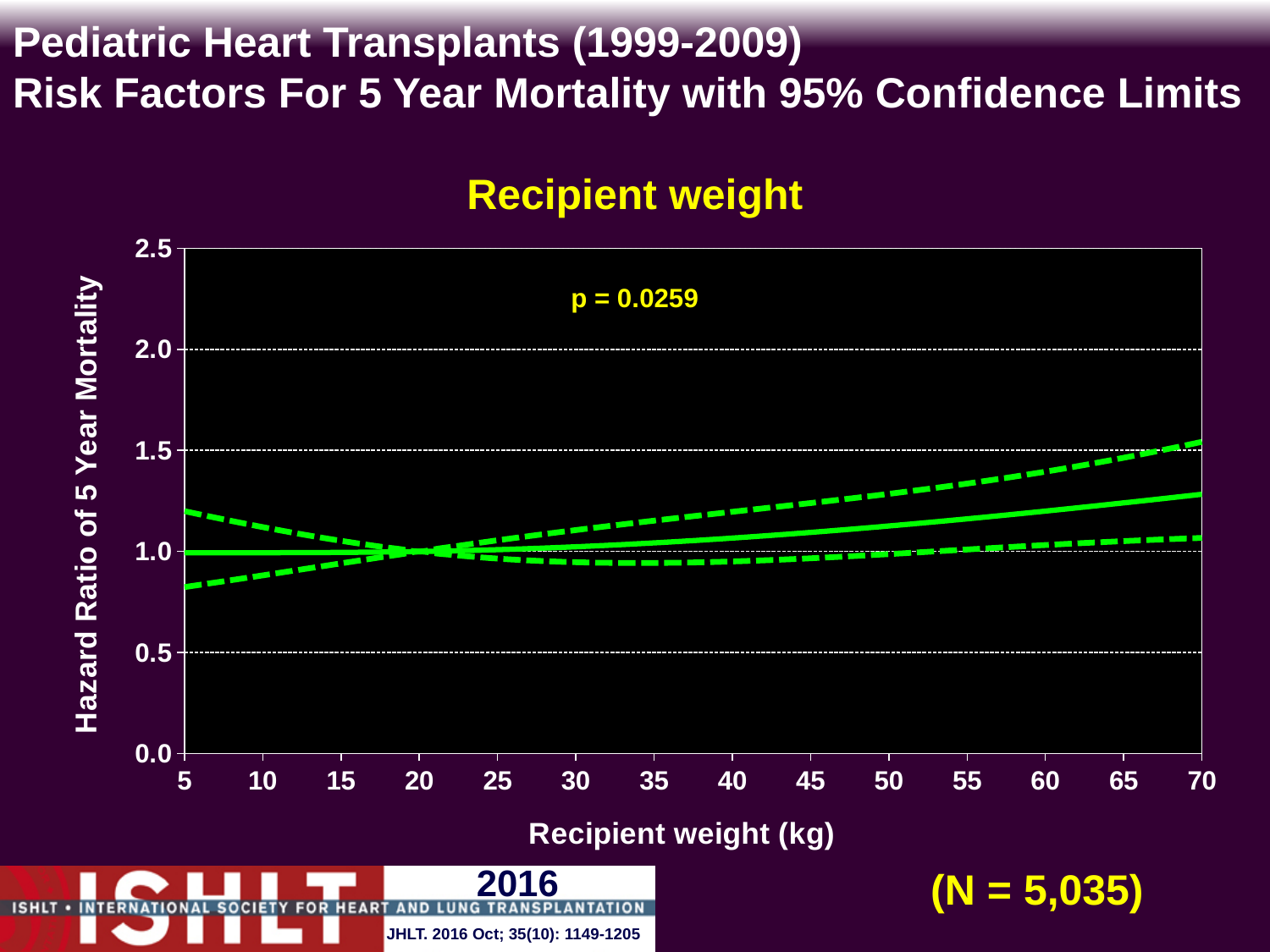
Is the lower dashed confidence limit at 5 kg greater or less than 1.0? less Does the solid hazard ratio line rise or fall as recipient weight increases from 5 kg to 70 kg? rise Is the solid hazard ratio line at 70 kg greater or less than 1.5? less What is the label of the y axis? Hazard Ratio of 5 Year Mortality Is the upper dashed confidence limit at 5 kg greater or less than 1.5? less How many lines are plotted on the chart? 3 What is the title of the chart? Recipient weight What is the p-value printed on the chart? p = 0.0259 What kind of chart is shown on the slide? line chart How many tick labels are shown on the x axis? 14